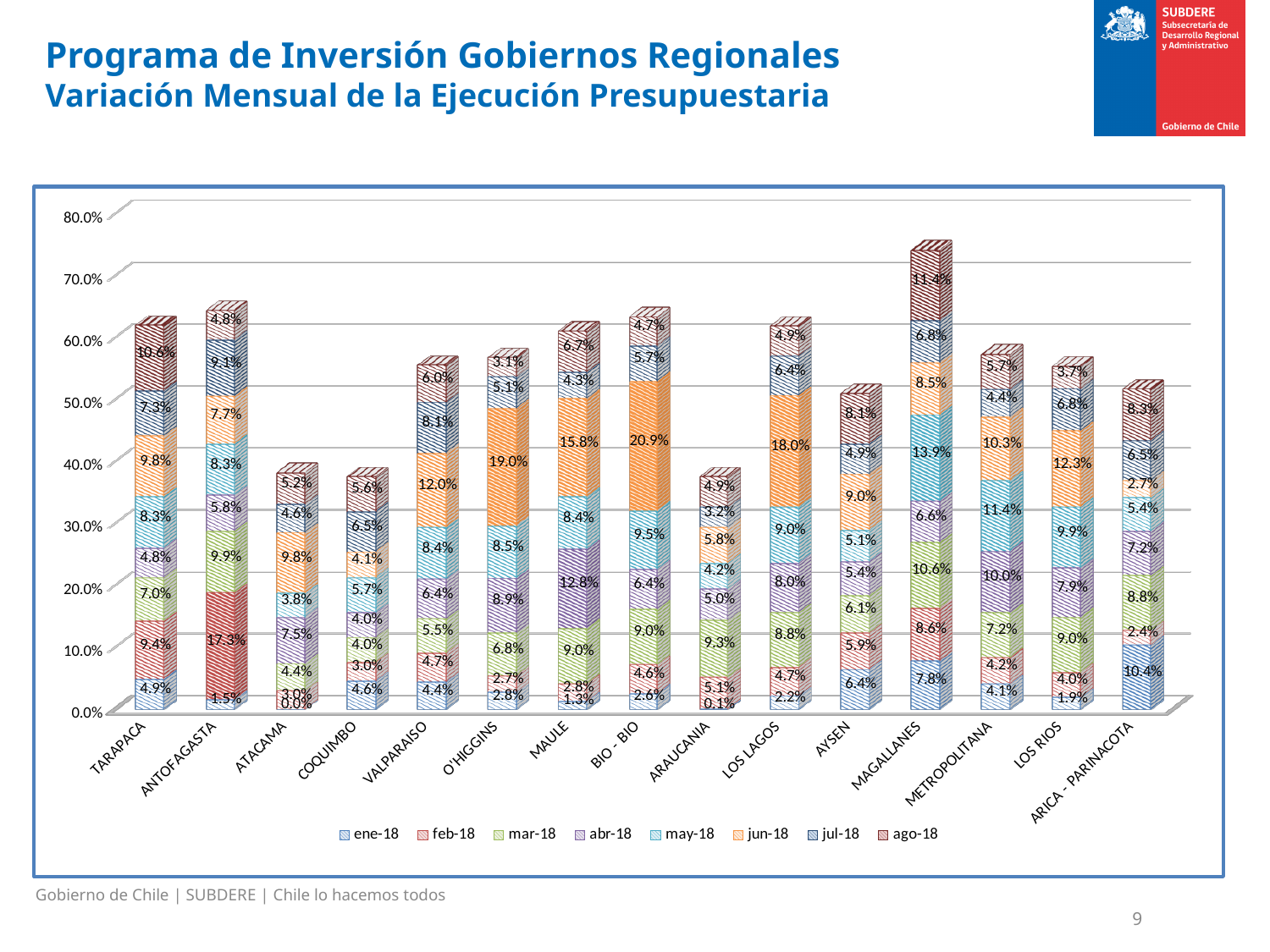
Which series is listed last in the legend? ago-18 What kind of chart is shown on the slide? Stacked bar chart What is the jun-18 value for BIO - BIO? 20.9% What is the ene-18 value for ARICA - PARINACOTA? 10.4% Which region has the highest jun-18 value? BIO - BIO How many series does the legend list? 8 How many regions are shown along the x axis of the chart? 15 Which region has the tallest stacked bar overall? MAGALLANES What is the total of the stacked bar for COQUIMBO? 37.5% What is the feb-18 value for ANTOFAGASTA? 17.3% Which is larger, the may-18 value for MAGALLANES or the may-18 value for METROPOLITANA? MAGALLANES What is the difference between the jun-18 values of O'HIGGINS and VALPARAISO? 7.0%